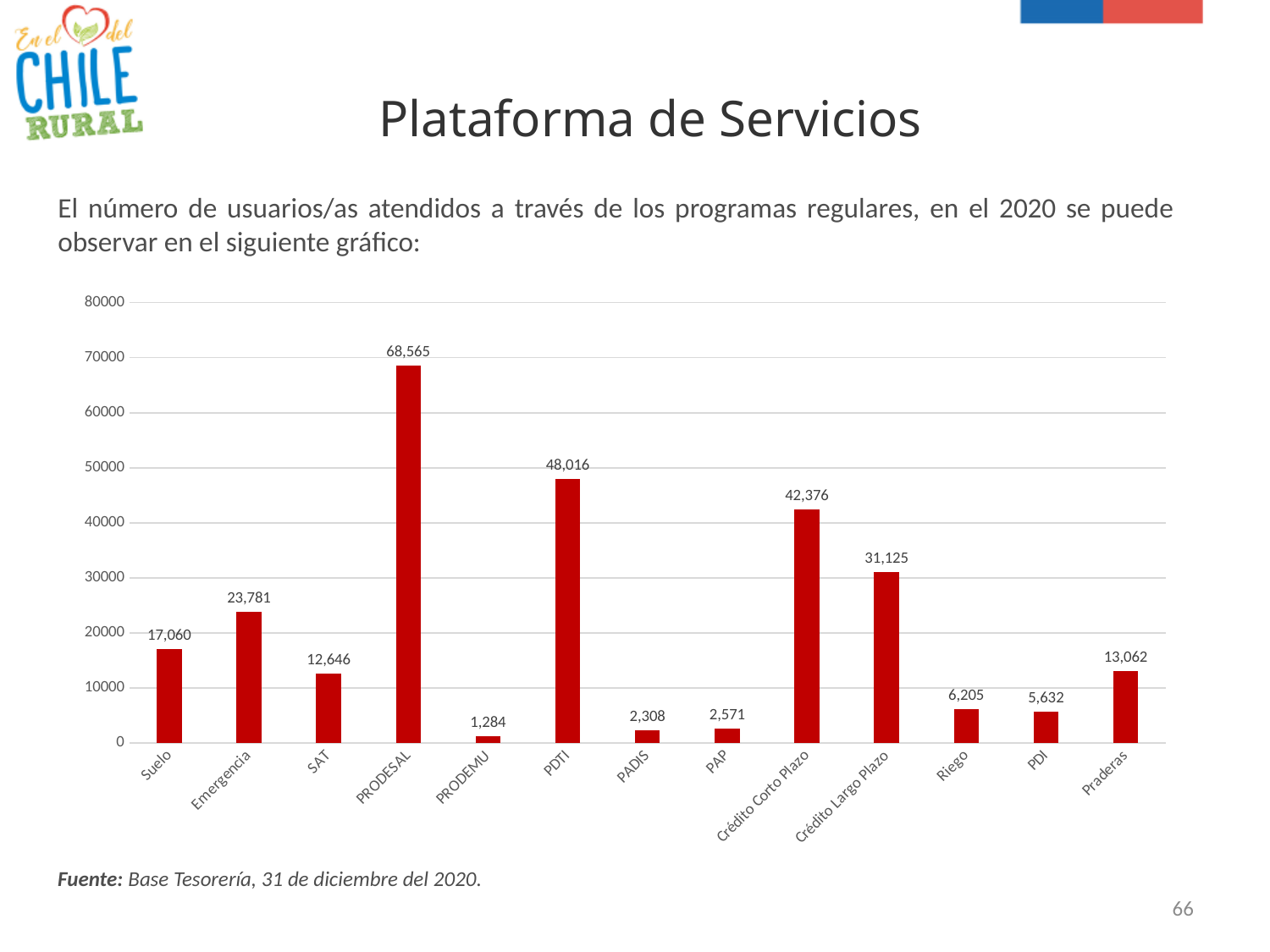
How many categories are shown on the x axis? 13 Is the value for Crédito Largo Plazo greater or less than 30000? greater Which category has the lowest value? PRODEMU Which is larger, the value for Praderas or the value for SAT? Praderas What is the value for Crédito Corto Plazo? 42,376 What is the difference between the values for Emergencia and Suelo? 6,721 What is the value for Riego? 6,205 What is the value for PRODESAL? 68,565 What kind of chart is shown on the slide? bar chart Which category has the highest value? PRODESAL What is the difference between the values for PDTI and Crédito Corto Plazo? 5,640 What colour are the bars in the chart? red